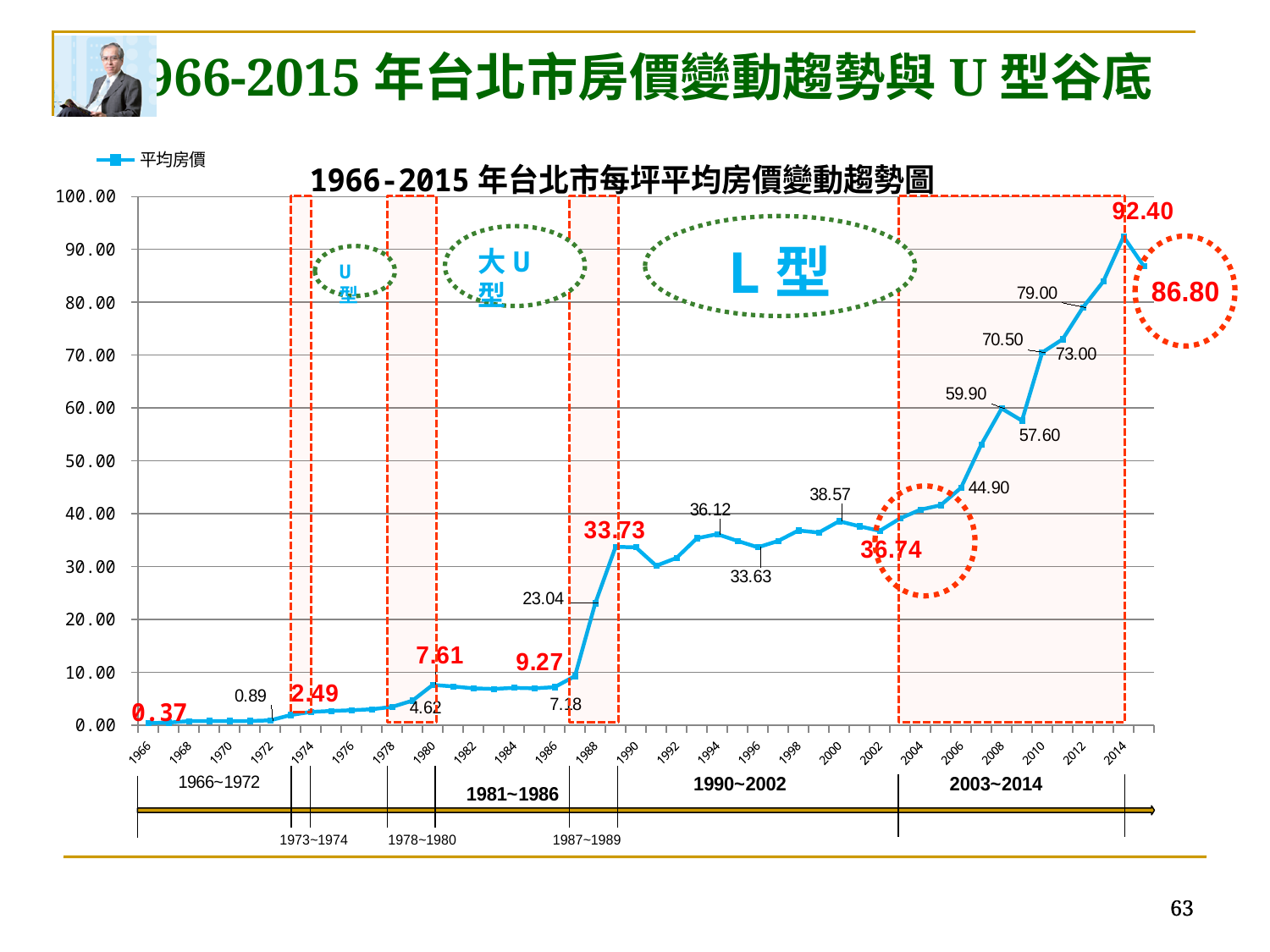
What is the title of the chart? 1966-2015 年台北市每坪平均房價變動趨勢圖 Which is larger, the value for 2008 or the value for 2009? 2008 What is the highest value plotted on the chart? 92.40 What kind of chart is shown on the slide? line chart What is the difference between the 2014 value (92.40) and the 2015 value (86.80)? 5.60 What is the lowest value plotted on the chart? 0.37 What is the value for 2008? 59.90 What is the name of the series shown in the legend? 平均房價 Is the value for 2006 greater or less than 40? greater How many series does the legend list? 1 In which year does the average house price reach its peak? 2014 What is the value for 2015, the last point on the chart? 86.80